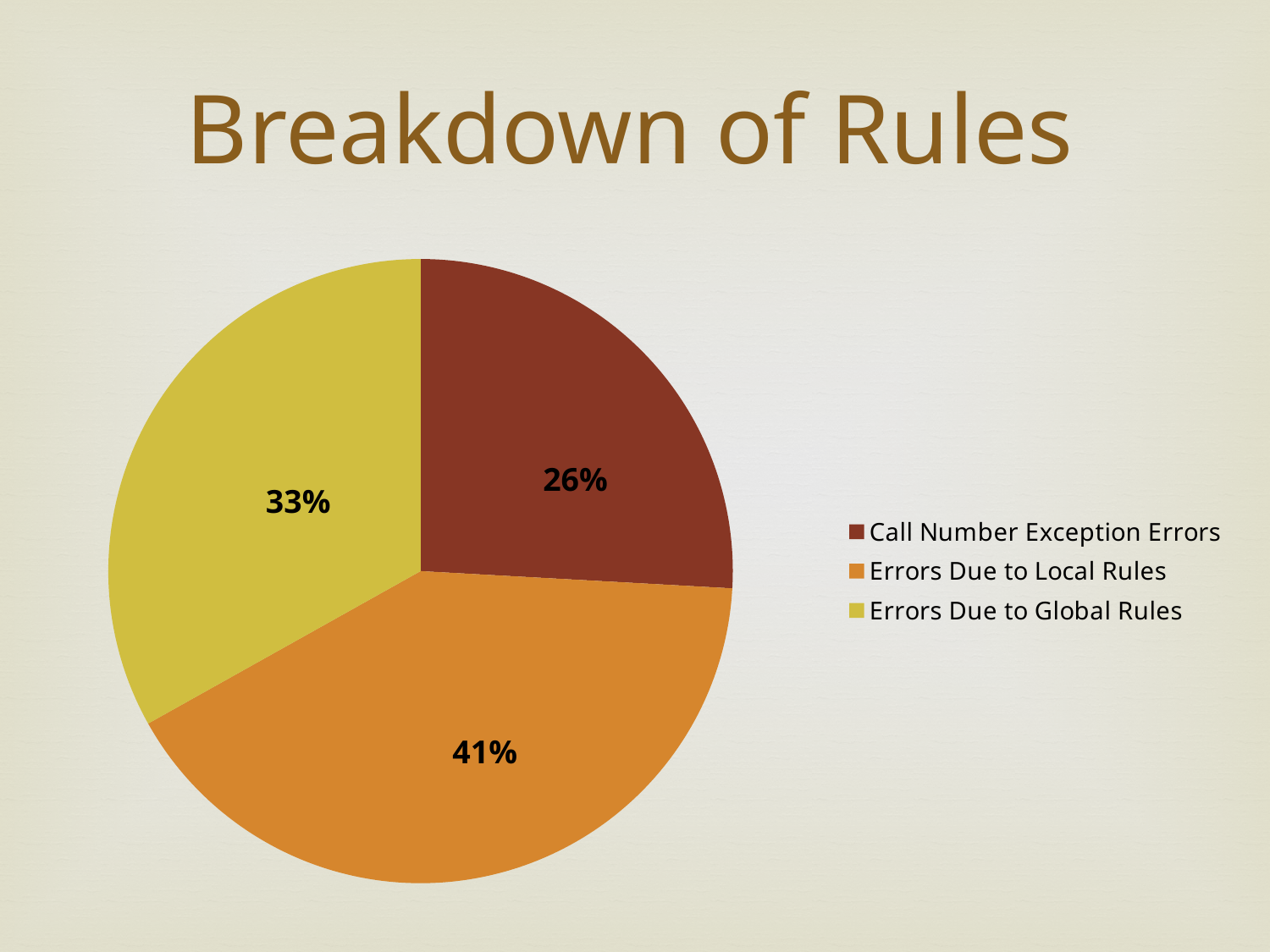
Which colour represents Errors Due to Global Rules in the legend? yellow What percentage of the pie is Errors Due to Global Rules? 33% What is the difference in percentage points between Errors Due to Local Rules and Errors Due to Global Rules? 8 What type of chart is shown on the slide? pie chart Which is larger: Errors Due to Global Rules or Call Number Exception Errors? Errors Due to Global Rules What is the title of the chart? Breakdown of Rules Which category has the smallest share of the pie? Call Number Exception Errors Which category has the largest share of the pie? Errors Due to Local Rules What is the difference in percentage points between Errors Due to Local Rules and Call Number Exception Errors? 15 How many slices does the pie chart have? 3 What percentage of the pie is Errors Due to Local Rules? 41% What percentage of the pie is Call Number Exception Errors? 26%